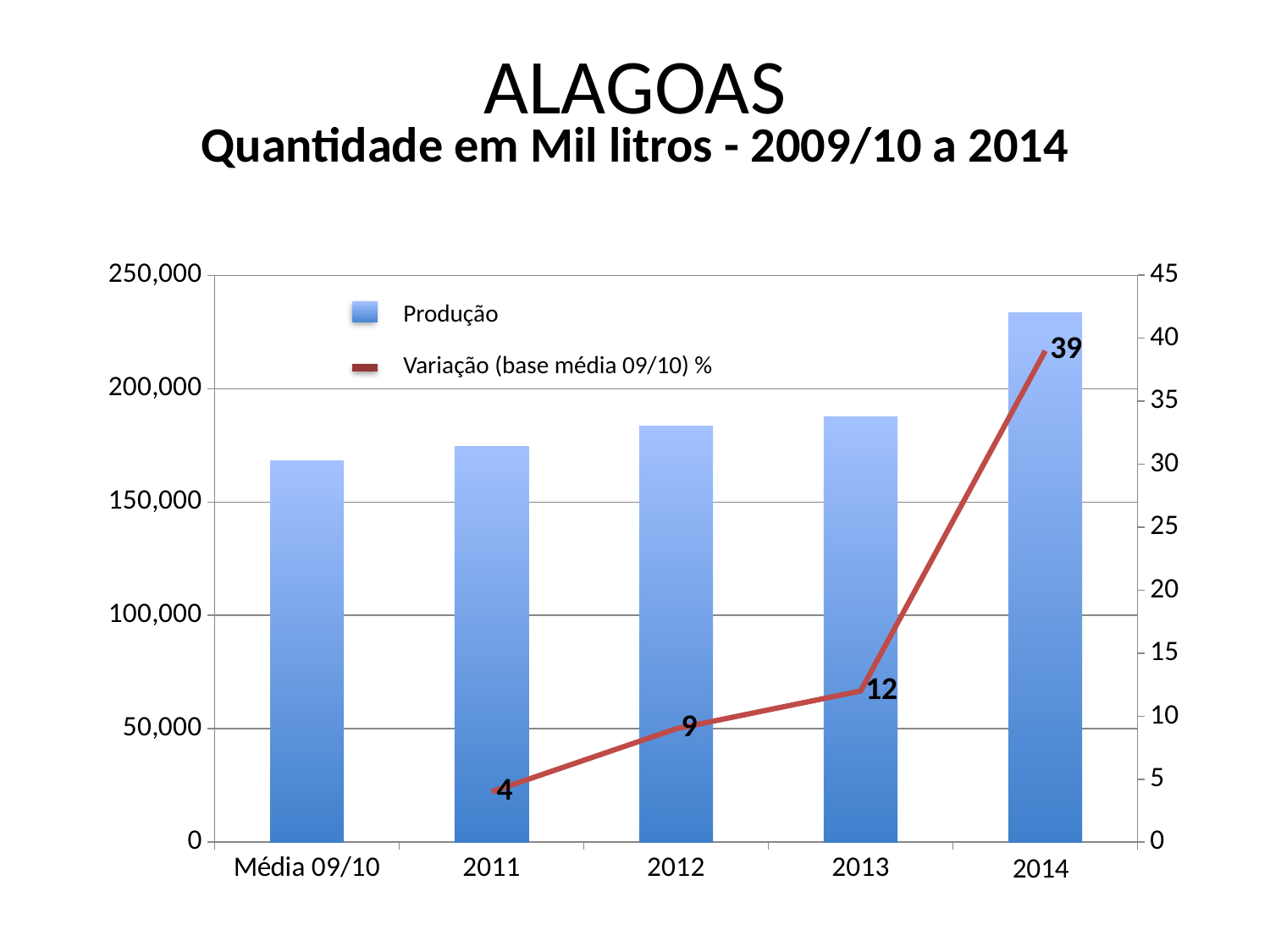
Does the Variação line rise or fall from 2011 to 2014? rise How many series does the legend list? 2 Is the Produção value for Média 09/10 greater or less than 200,000? less Which category has the lowest Produção bar? Média 09/10 What is the value of Variação (base média 09/10) % for 2014? 39 What is the difference between the Variação values for 2014 and 2013? 27 How many categories are shown on the x axis? 5 What is the value of Variação (base média 09/10) % for 2013? 12 Is the Produção value for 2014 greater or less than 200,000? greater Which has a larger Produção value, 2011 or 2014? 2014 What is the value of Variação (base média 09/10) % for 2011? 4 Which year has the highest Produção bar? 2014